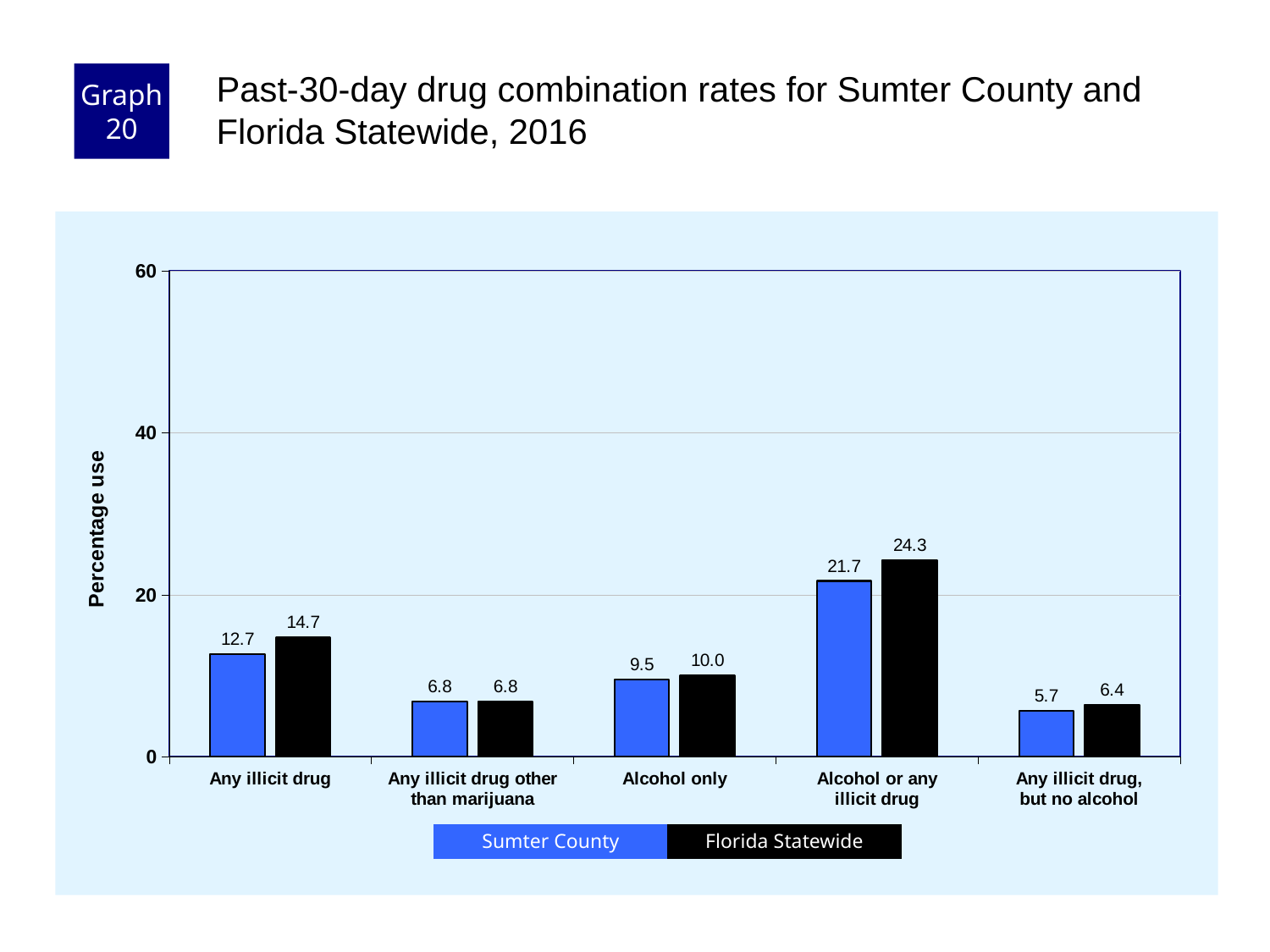
Which is larger for Alcohol only: the Sumter County value or the Florida Statewide value? Florida Statewide What is the difference between the Florida Statewide and Sumter County values for Alcohol or any illicit drug? 2.6 What is the difference between the Florida Statewide and Sumter County values for Any illicit drug? 2.0 Is the Florida Statewide value for Alcohol or any illicit drug greater or less than 20? greater How many categories are shown on the x axis? 5 What is the Florida Statewide value for Any illicit drug, but no alcohol? 6.4 Which category has the highest Sumter County value? Alcohol or any illicit drug How many series does the legend list? 2 What kind of chart is shown on the slide? Bar chart Which category has the lowest Florida Statewide value? Any illicit drug, but no alcohol What is the Sumter County value for Any illicit drug? 12.7 What is the Florida Statewide value for Alcohol or any illicit drug? 24.3